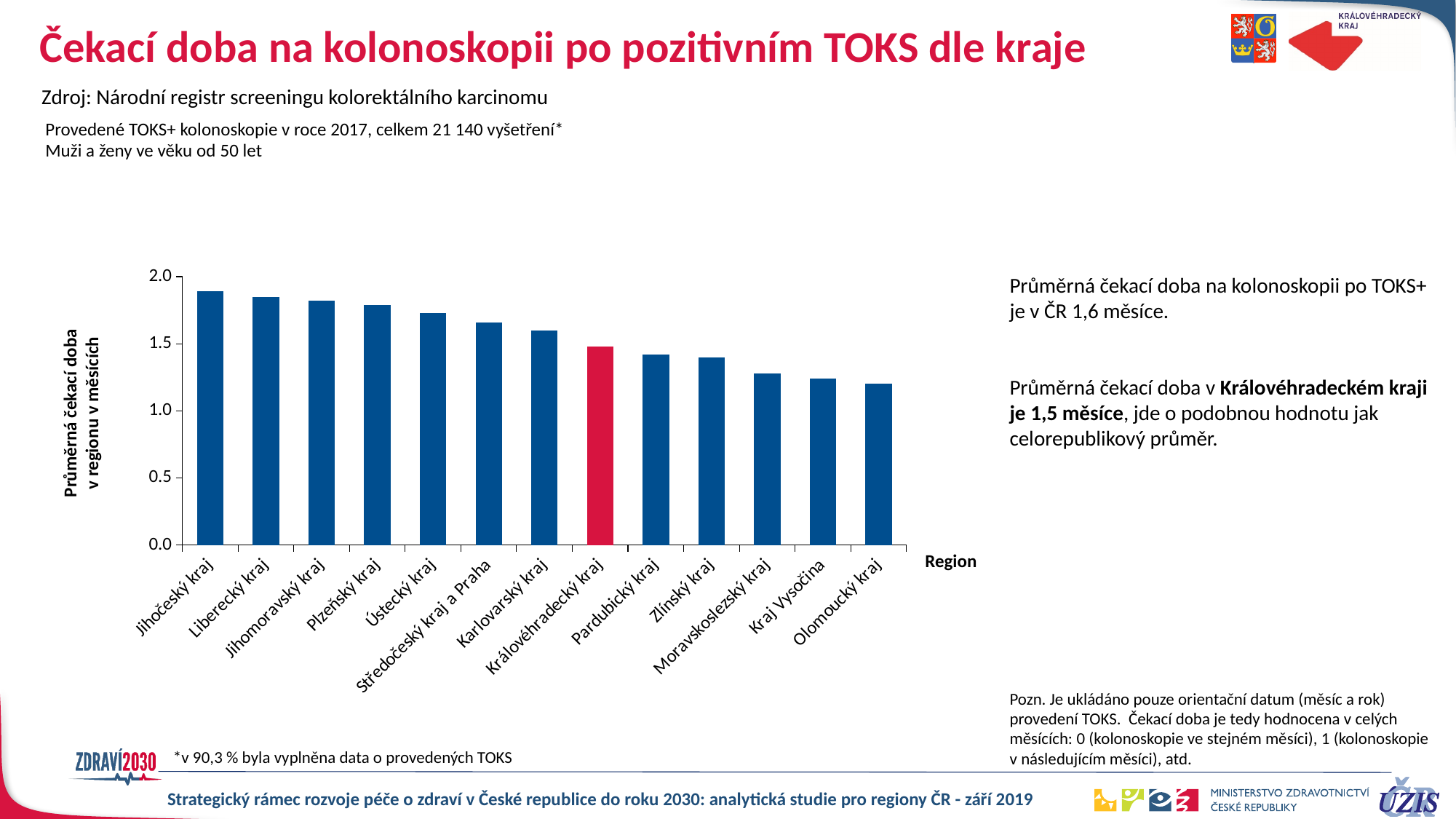
Is the value for Olomoucký kraj greater or less than 1.5? less How many regions are plotted on the x axis of the chart? 13 Which region has the lowest average waiting time in the chart? Olomoucký kraj Which region has the highest average waiting time in the chart? Jihočeský kraj Do the bar values rise or fall from left to right along the x axis? fall Is the value for Jihočeský kraj greater or less than 1.5? greater What is the label of the y axis of the chart? Průměrná čekací doba v regionu v měsících Which has a larger value, Jihočeský kraj or Olomoucký kraj? Jihočeský kraj Is the value for Liberecký kraj greater or less than 1.5? greater Which region's bar is highlighted in red in the chart? Královéhradecký kraj What kind of chart is shown on the slide? bar chart